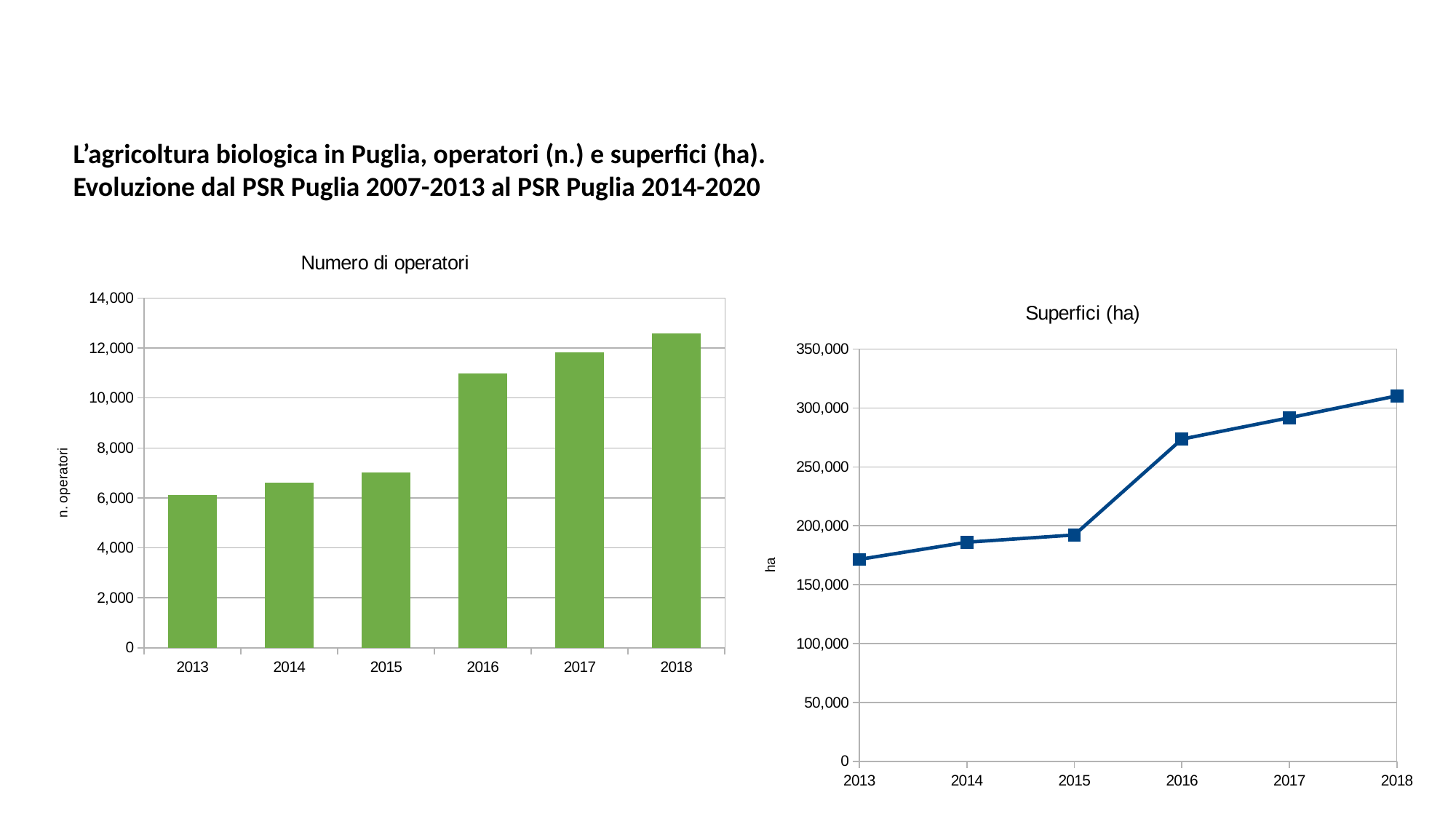
On the 'Numero di operatori' chart, how many years are shown on the x axis? 6 On the 'Superfici (ha)' chart, what is the label of the y axis? ha On the 'Numero di operatori' chart, is the value for 2016 greater or less than 10,000? greater On the 'Superfici (ha)' chart, what kind of chart is shown? line chart On the 'Superfici (ha)' chart, is the value for 2016 greater or less than 250,000? greater On the 'Numero di operatori' chart, which year has the lowest number of operators? 2013 On the 'Numero di operatori' chart, is the value for 2015 greater or less than 8,000? less On the 'Numero di operatori' chart, which year has the highest number of operators? 2018 On the 'Numero di operatori' chart, what kind of chart is shown? bar chart On the 'Superfici (ha)' chart, do the values rise or fall from 2013 to 2018? rise On the 'Numero di operatori' chart, which is larger, the value for 2014 or the value for 2017? 2017